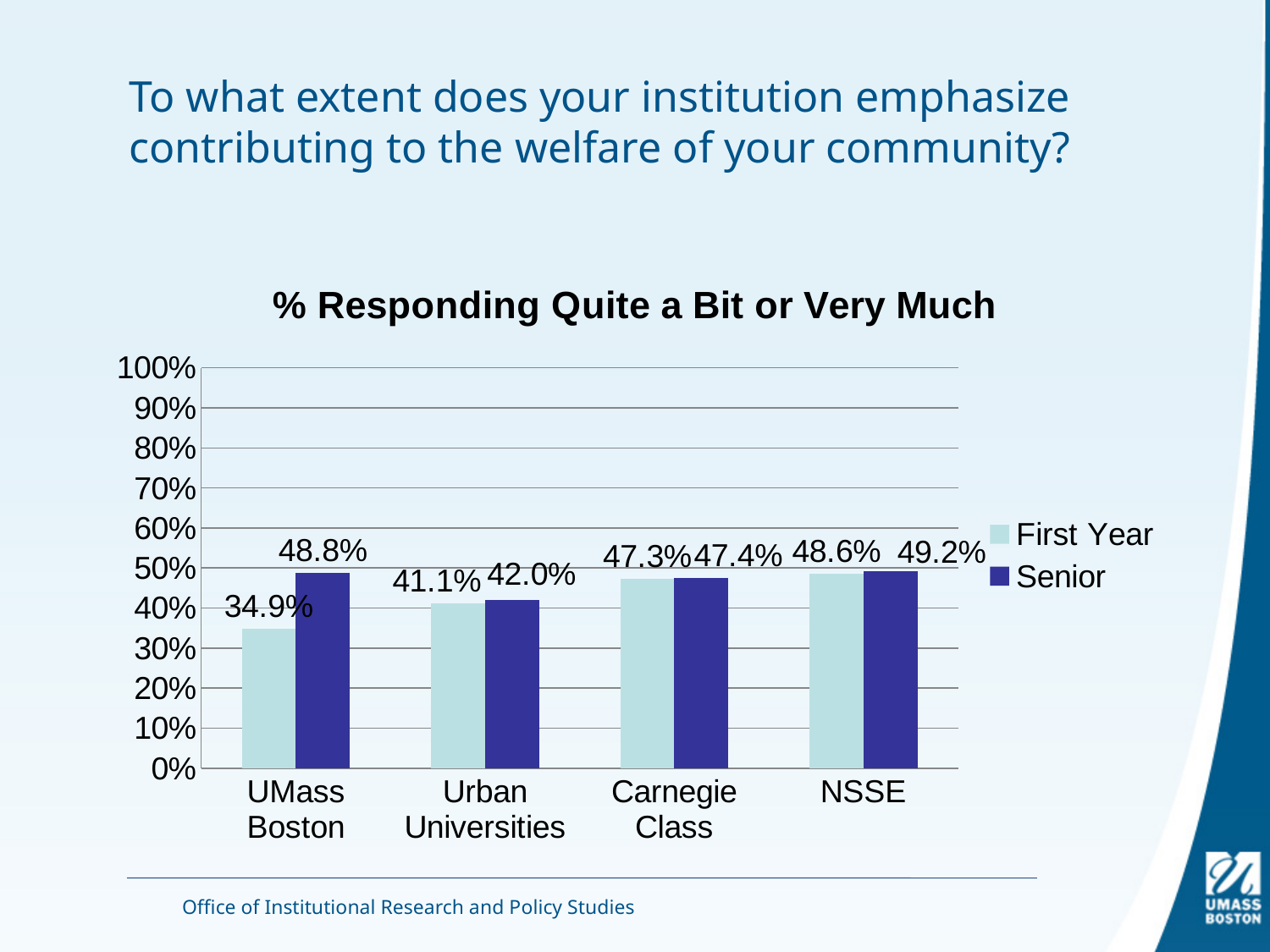
What is the Senior value for Urban Universities? 42.0% How many categories are shown on the x axis? 4 How many series does the legend list? 2 What is the title of the chart? % Responding Quite a Bit or Very Much Which category has the lowest First Year value? UMass Boston Which category has the highest Senior value? NSSE Which is larger, the First Year value for NSSE or the First Year value for Urban Universities? NSSE What is the First Year value for UMass Boston? 34.9% What kind of chart is shown on the slide? Bar chart What is the difference between the Senior and First Year values for UMass Boston? 13.9% What is the Senior value for NSSE? 49.2% What is the First Year value for Carnegie Class? 47.3%